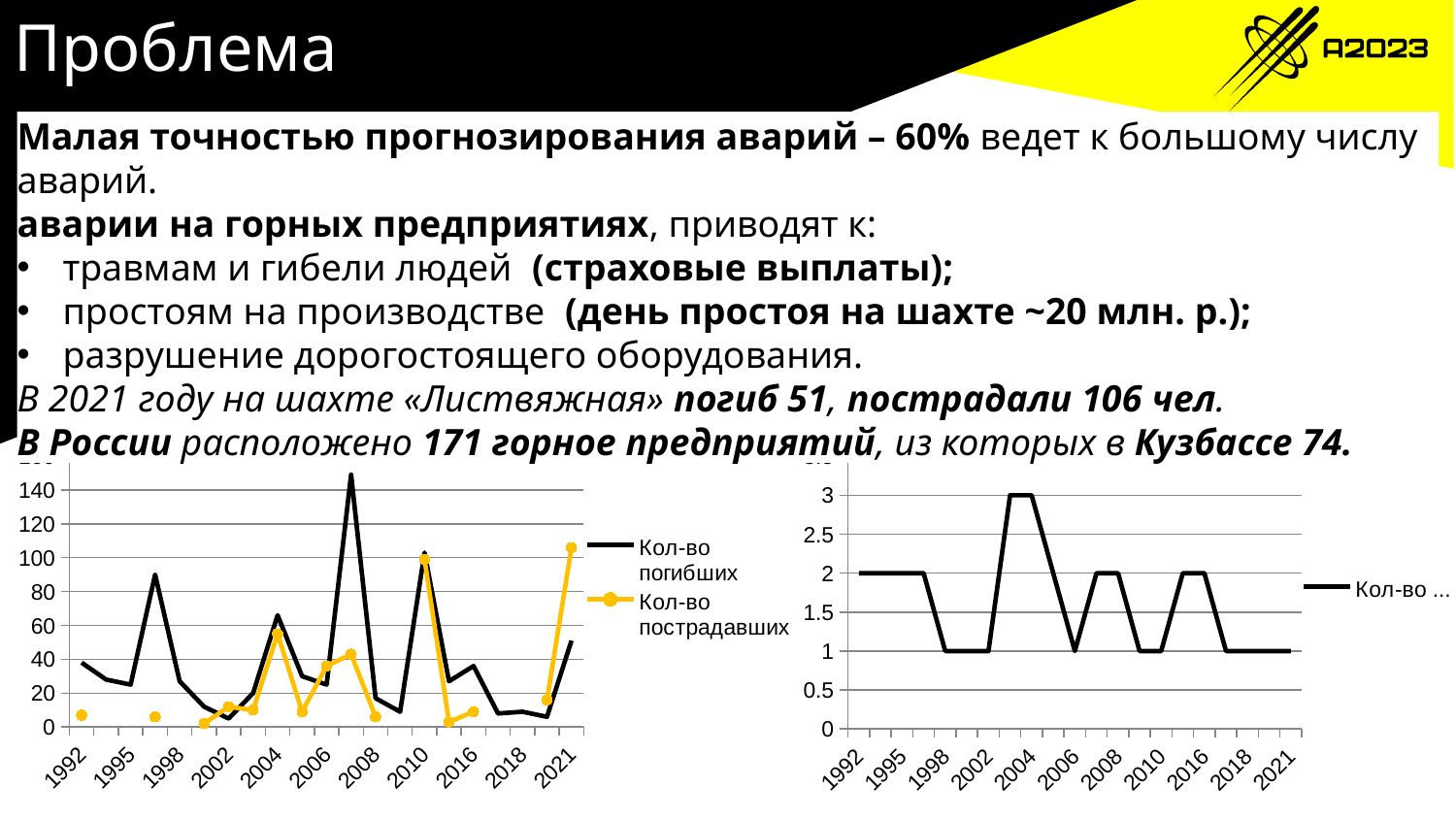
In the right chart, what is the value for 1992? 2 How many series does the legend of the right chart list? 1 How many series does the legend of the left chart list? 2 In the right chart, what is the lowest value reached by the line? 1 In the left chart, which colour is the line for Кол-во пострадавших? yellow In the left chart, what are the two series named in the legend? Кол-во погибших, Кол-во пострадавших In the right chart, what is the highest value reached by the line? 3 In the left chart, is the value of Кол-во пострадавших for 2021 greater or less than 80? greater In the right chart, what is the value for 2021? 1 In the left chart, is the peak value of Кол-во погибших greater or less than 140? greater What kind of chart is the left chart on the slide? line chart In the left chart, for 2021, which series has the larger value: Кол-во погибших or Кол-во пострадавших? Кол-во пострадавших